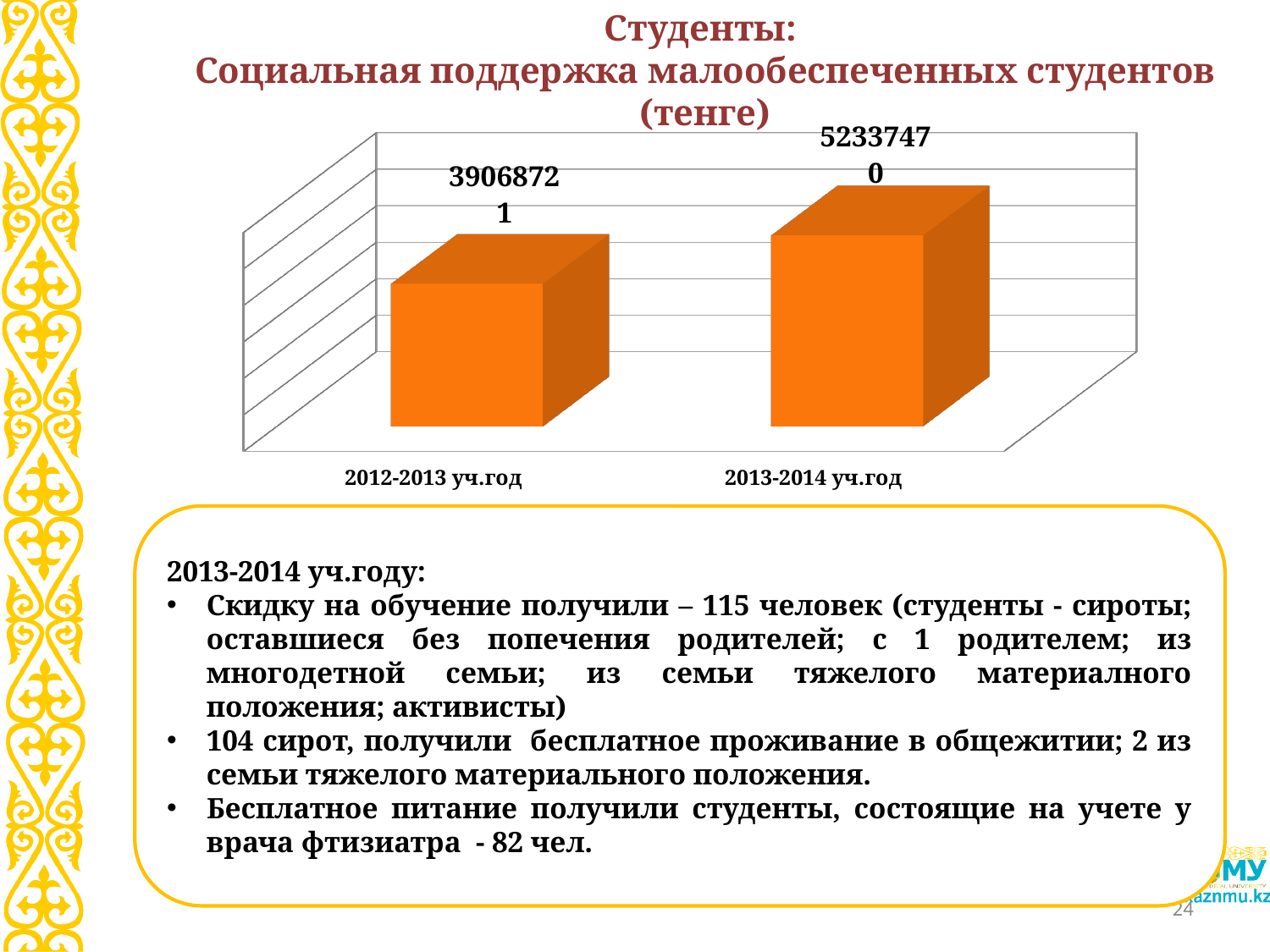
What unit is given in parentheses in the chart title? тенге Which is larger, the value for 2012-2013 уч.год or for 2013-2014 уч.год? 2013-2014 уч.год How many categories are shown on the x axis? 2 Which academic year has the lowest value? 2012-2013 уч.год What colour are the bars in the chart? orange What is the value for 2013-2014 уч.год? 52337470 What is the value for 2012-2013 уч.год? 39068721 What kind of chart is shown on the slide? bar chart Which academic year has the highest value? 2013-2014 уч.год Do the values rise or fall from 2012-2013 уч.год to 2013-2014 уч.год? rise What is the difference between the values for 2013-2014 уч.год and 2012-2013 уч.год? 13268749